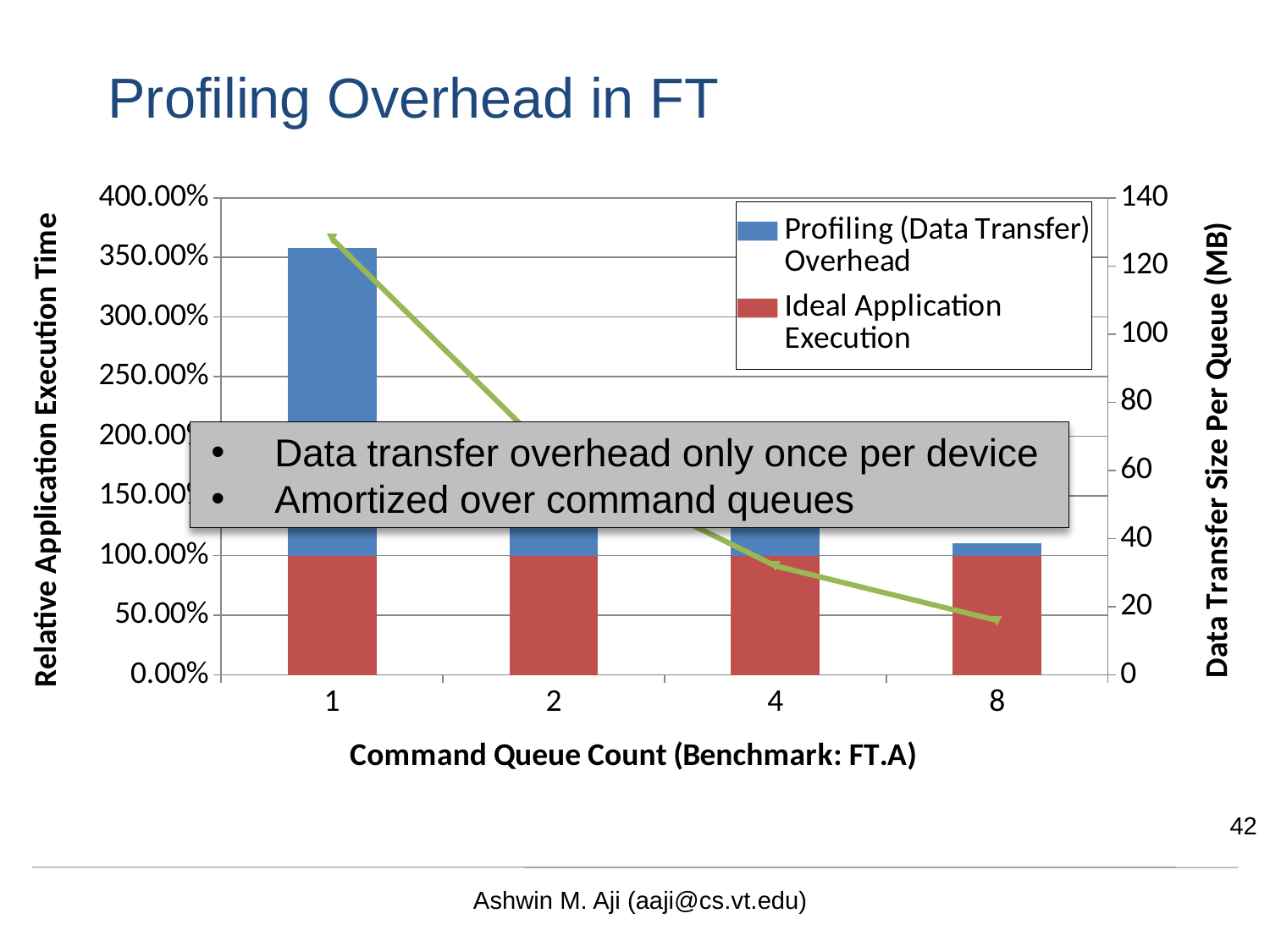
What kind of chart is shown on the slide? combination bar and line chart Is the total relative application execution time for command queue count 8 greater or less than 150.00%? less Is the data transfer size per queue for command queue count 1 greater or less than 120 MB? greater Is the data transfer size per queue for command queue count 8 greater or less than 20 MB? less Which has the larger total relative application execution time, command queue count 2 or command queue count 8? 2 How many series does the legend list? 2 What is the title of the x axis? Command Queue Count (Benchmark: FT.A) How many command queue count categories are shown on the x axis? 4 Which command queue count has the highest total relative application execution time? 1 Does the total relative application execution time rise or fall as the command queue count increases? fall Which command queue count has the lowest total relative application execution time? 8